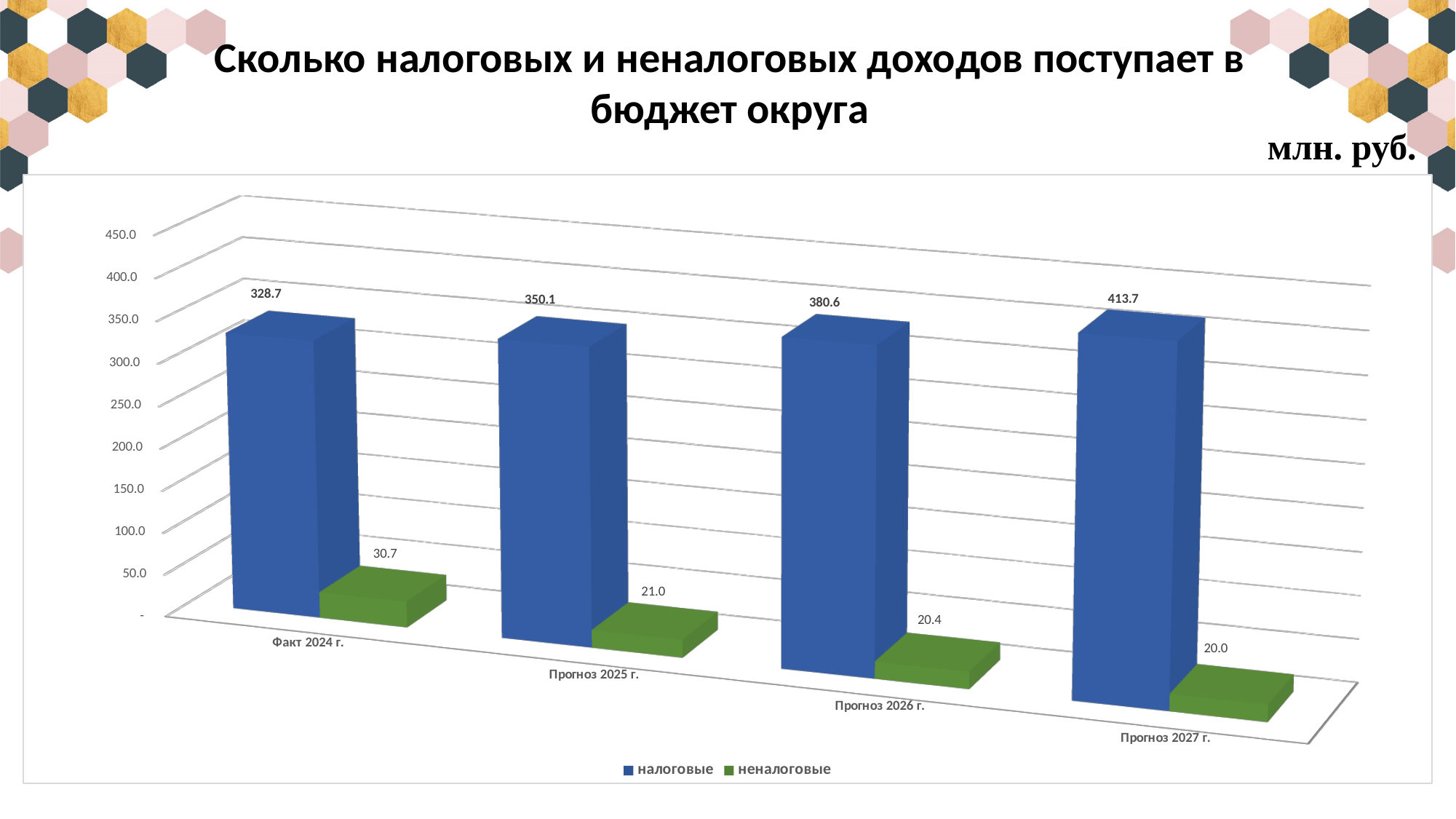
What kind of chart is shown on the slide? bar chart How many categories are shown on the x axis? 4 What is the value of налоговые for Факт 2024 г.? 328.7 What is the value of налоговые for Прогноз 2026 г.? 380.6 What is the value of неналоговые for Прогноз 2027 г.? 20.0 What is the value of неналоговые for Прогноз 2025 г.? 21.0 Do the values for налоговые rise or fall from Факт 2024 г. to Прогноз 2027 г.? rise What is the difference between налоговые for Прогноз 2027 г. and Факт 2024 г.? 85.0 Which is larger: неналоговые for Факт 2024 г. or for Прогноз 2026 г.? Факт 2024 г. How many series does the legend list? 2 Which category has the highest value for налоговые? Прогноз 2027 г. Which category has the lowest value for неналоговые? Прогноз 2027 г.